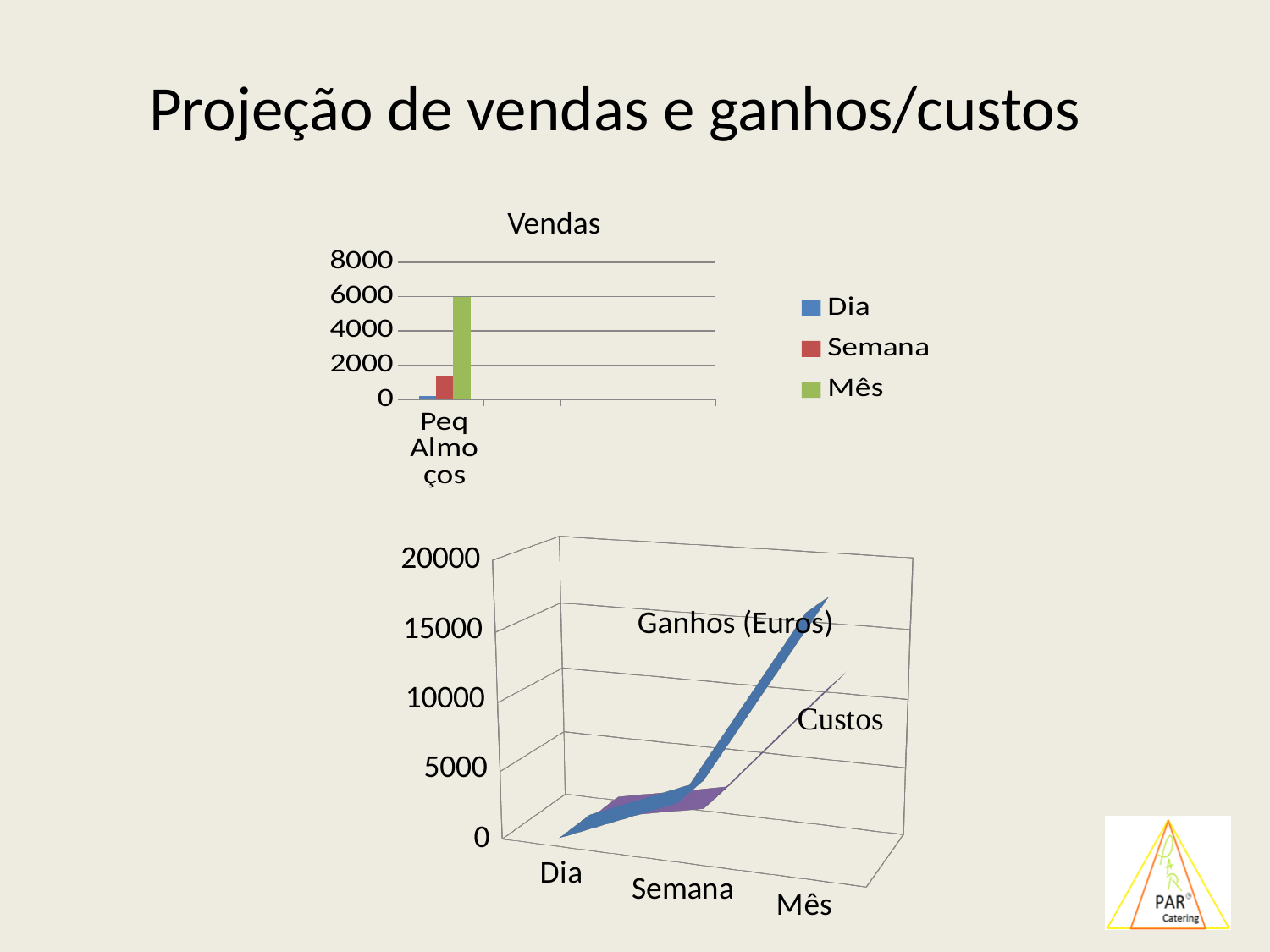
How many categories are shown on the x axis of the Vendas chart? 1 How many categories are shown on the x axis of the bottom chart? 3 What kind of chart is the Vendas chart at the top of the slide? Bar chart In the Vendas chart, which series has the highest value for Peq Almoços? Mês In the Vendas chart, is the value for Mês greater or less than 4000? greater In the Vendas chart, which series has the lowest value for Peq Almoços? Dia In the bottom chart, is the Ganhos (Euros) value for Mês greater or less than 10000? greater In the bottom chart, do the Ganhos (Euros) values rise or fall from Dia to Mês? rise How many series does the legend of the Vendas chart list? 3 In the Vendas chart, is the value for Semana greater or less than 2000? less In the bottom chart, which is larger at Mês, Ganhos (Euros) or Custos? Ganhos (Euros) Which series are listed in the legend of the Vendas chart? Dia, Semana, Mês